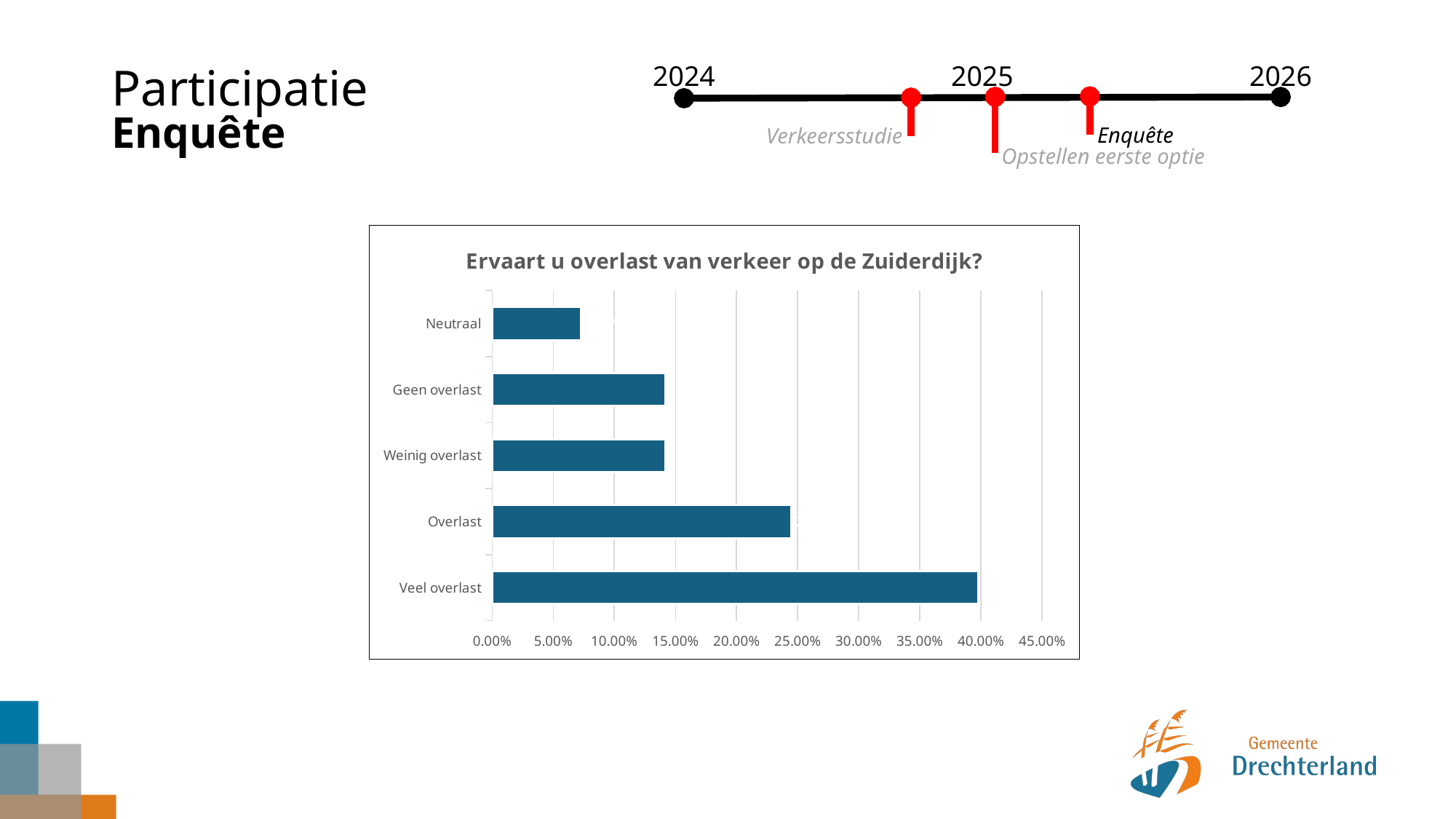
How many categories does the chart show? 5 Is the value for Veel overlast greater or less than 35.00%? greater Is the value for Weinig overlast greater or less than 20.00%? less Is the value for Geen overlast greater or less than 10.00%? greater What kind of chart is shown on the slide? bar chart Which category has the highest value? Veel overlast What is the highest value shown on the chart's horizontal axis? 45.00% What is the title of the chart? Ervaart u overlast van verkeer op de Zuiderdijk? Which category has the lowest value? Neutraal Which is larger, the value for Veel overlast or the value for Overlast? Veel overlast